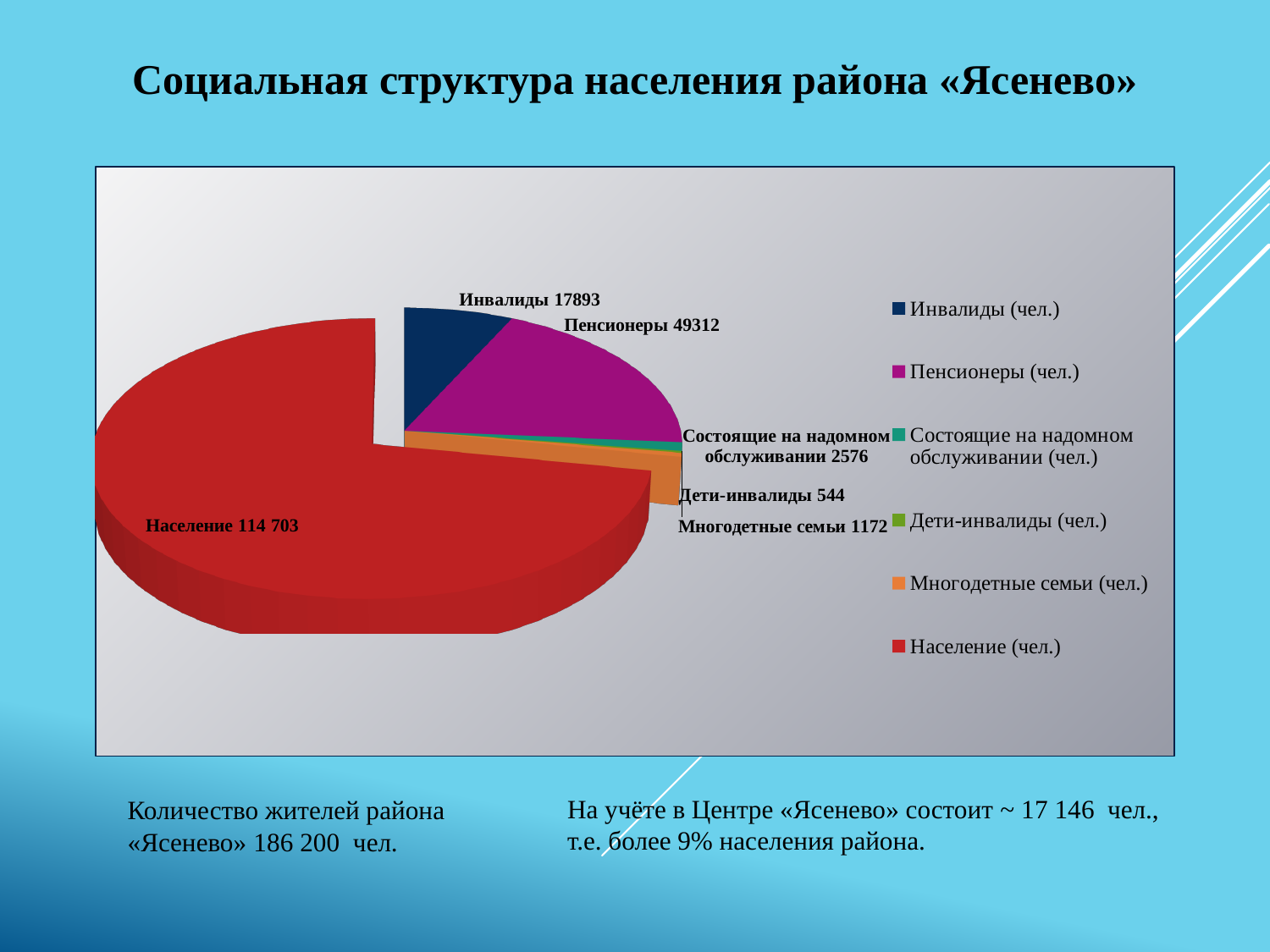
What is the value for Инвалиды in the pie chart? 17893 Which is larger, the value for Многодетные семьи or the value for Дети-инвалиды? Многодетные семьи Which category has the smallest slice in the pie chart? Дети-инвалиды What is the value for Пенсионеры in the pie chart? 49312 What is the value for Состоящие на надомном обслуживании in the pie chart? 2576 What is the value for Многодетные семьи in the pie chart? 1172 How many entries does the legend of the pie chart list? 6 Which category has the largest slice in the pie chart? Население What is the title of the slide containing the pie chart? Социальная структура населения района «Ясенево» What is the difference between the values for Пенсионеры and Инвалиды? 31419 What is the value for Дети-инвалиды in the pie chart? 544 What type of chart is shown on the slide? Pie chart